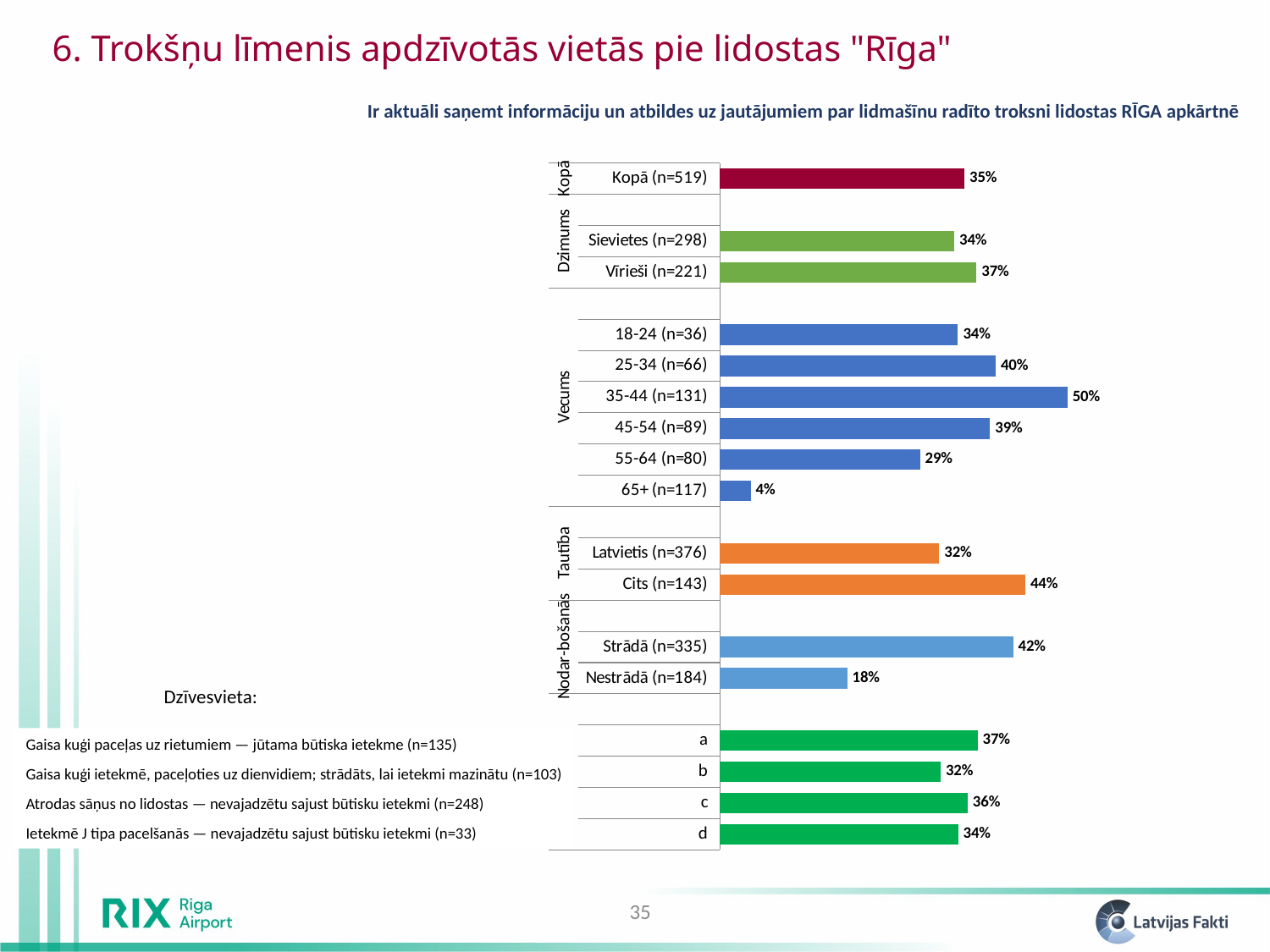
What is the value for 35-44 (n=131)? 50% What is the value for the category labelled c? 36% What kind of chart is shown on the slide? Bar chart Which category has the highest value? 35-44 (n=131) Which category has the lowest value? 65+ (n=117) What is the difference between the values for Strādā (n=335) and Nestrādā (n=184)? 24% What is the value for Cits (n=143)? 44% Which is larger, the value for Vīrieši (n=221) or Sievietes (n=298)? Vīrieši (n=221) How many bars are plotted in the chart? 17 What is the difference between the values for Cits (n=143) and Latvietis (n=376)? 12% What is the value for Nestrādā (n=184)? 18% What is the value for Kopā (n=519)? 35%